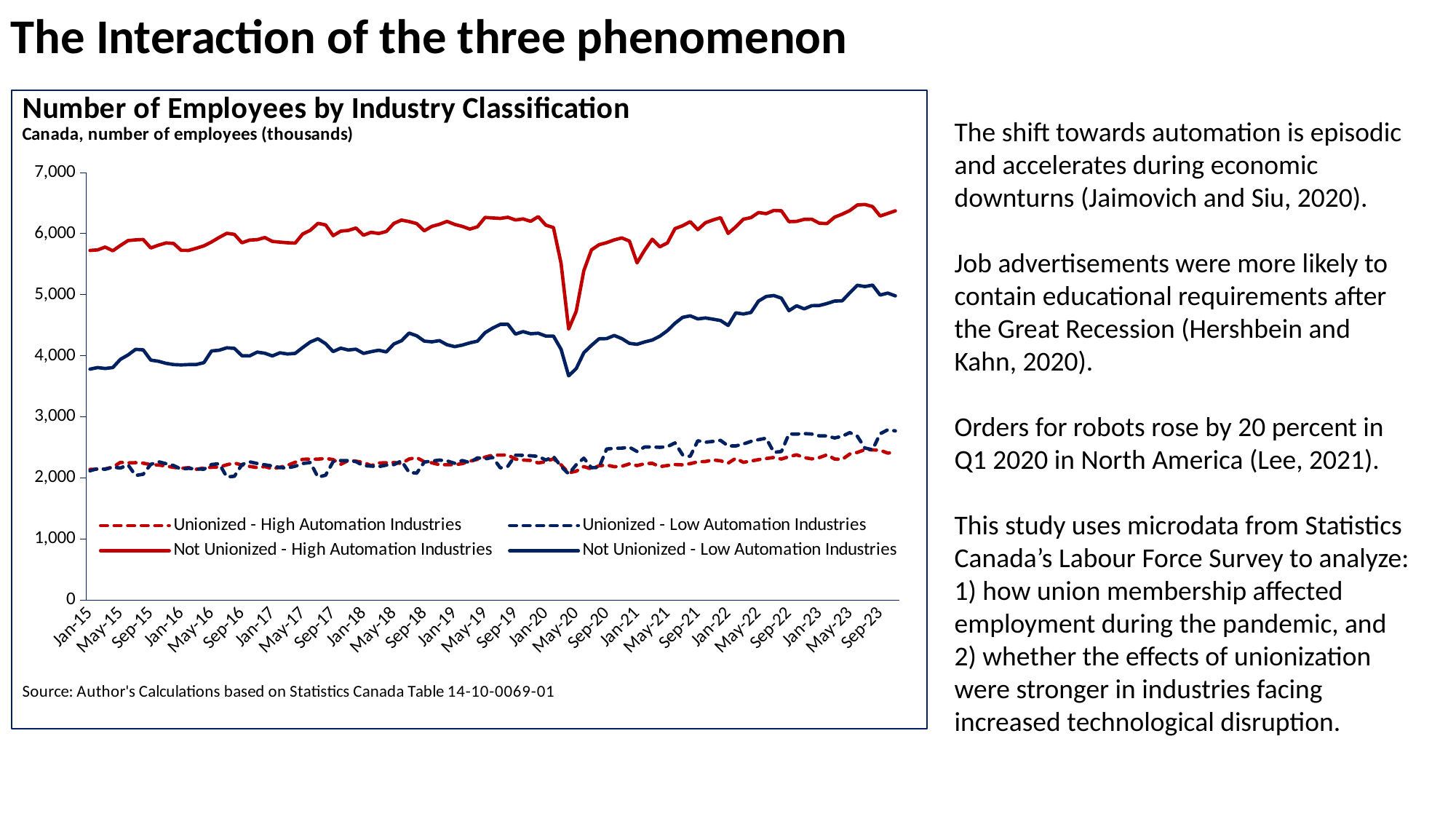
In Sep-23, which is larger: Not Unionized - High Automation Industries or Not Unionized - Low Automation Industries? Not Unionized - High Automation Industries Overall, does the Not Unionized - Low Automation Industries series rise or fall from Jan-15 to Sep-23? rise What is the title of the chart? Number of Employees by Industry Classification Is the value for Not Unionized - High Automation Industries at its dip around May-20 greater or less than 5,000? less Which series in the chart is drawn with dashed lines? Unionized - High Automation Industries and Unionized - Low Automation Industries Is the value for Not Unionized - High Automation Industries in Jan-15 greater or less than 5,000? greater Is the value for Not Unionized - Low Automation Industries in Jan-15 greater or less than 4,000? less What kind of chart is shown on the slide? line chart How many series does the chart's legend list? 4 Which series has the highest values across the whole period? Not Unionized - High Automation Industries